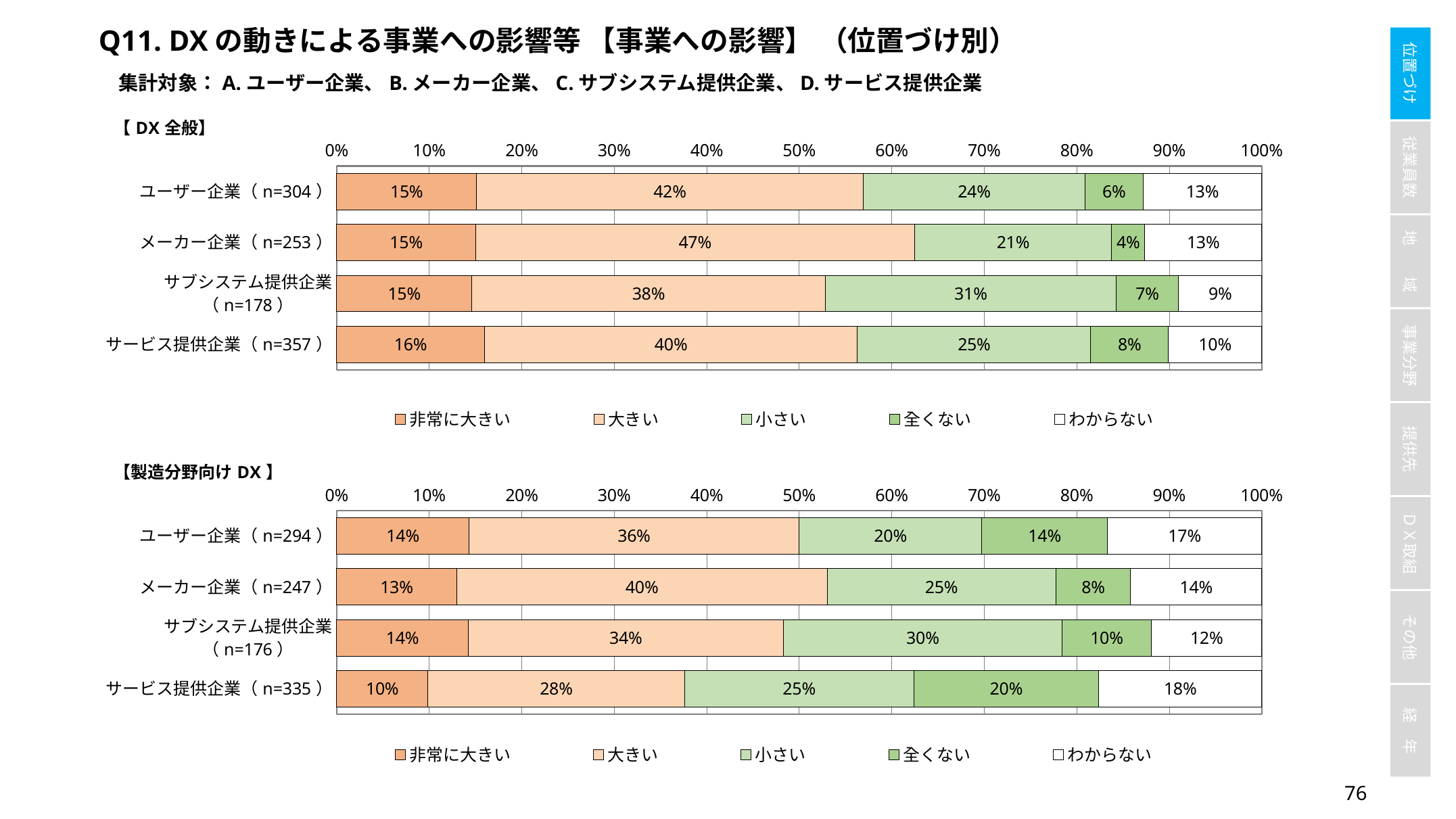
How many series does the legend of the 【DX 全般】 chart list? 5 In the 【製造分野向け DX】 chart, what is the combined value of 非常に大きい and 大きい for メーカー企業 (n=247)? 53% In the 【製造分野向け DX】 chart, which category has the lowest value for 非常に大きい? サービス提供企業 (n=335) In the 【製造分野向け DX】 chart, what is the value of 全くない for サービス提供企業 (n=335)? 20% In the 【DX 全般】 chart, what is the value of 大きい for メーカー企業 (n=253)? 47% In the 【DX 全般】 chart, what is the value of 小さい for サブシステム提供企業 (n=178)? 31% In the 【製造分野向け DX】 chart, what is the value of わからない for ユーザー企業 (n=294)? 17% How many categories are shown in the 【製造分野向け DX】 chart? 4 In the 【DX 全般】 chart, which category has the highest value for 大きい? メーカー企業 (n=253) What type of chart is the 【DX 全般】 chart? Stacked bar chart In the 【製造分野向け DX】 chart, what is the difference between the 小さい values for サブシステム提供企業 (n=176) and ユーザー企業 (n=294)? 10% In the 【DX 全般】 chart, which is larger: the 全くない value for サービス提供企業 (n=357) or for メーカー企業 (n=253)? サービス提供企業 (n=357)